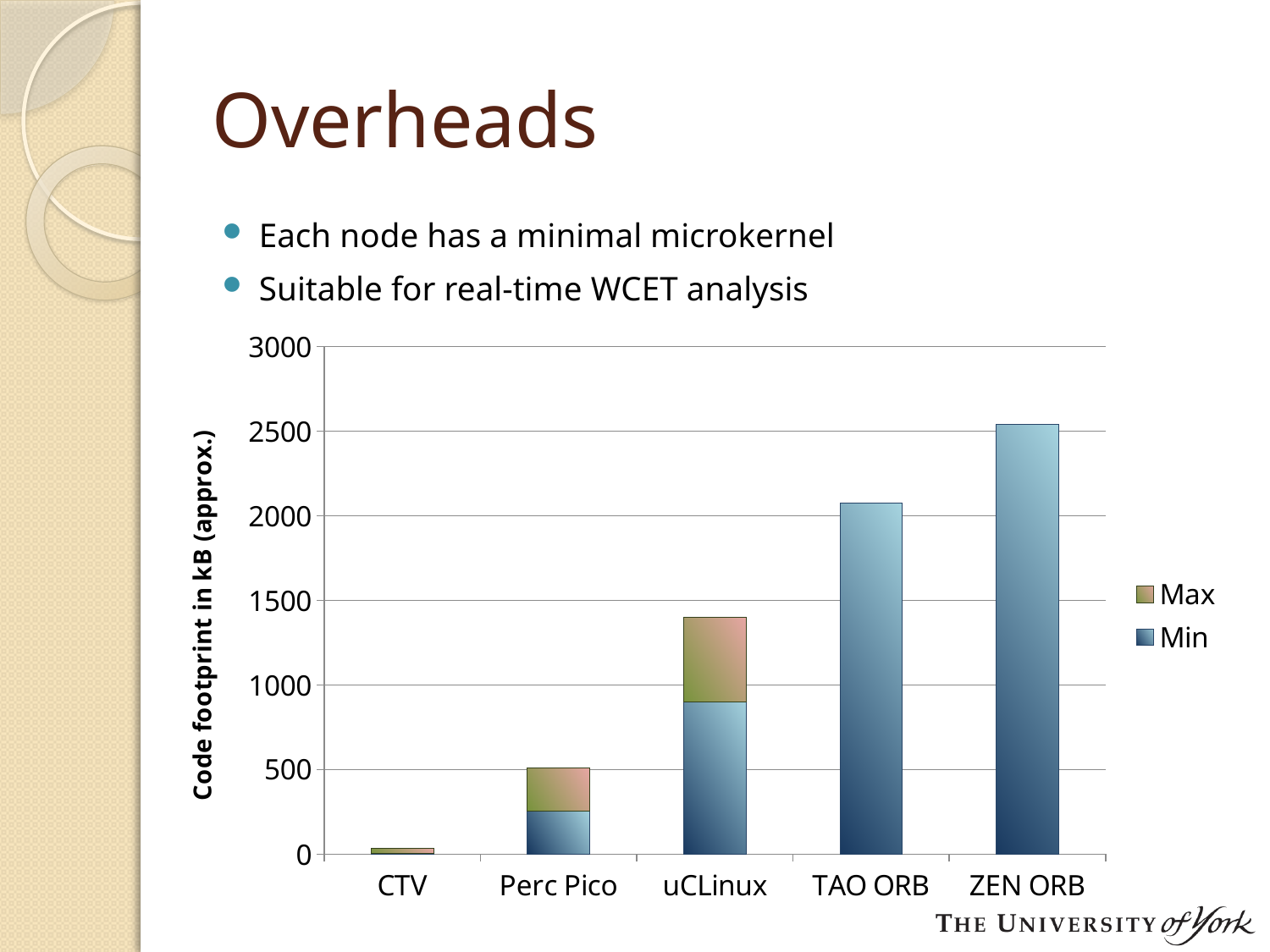
Is the value for CTV greater or less than 500? less What kind of chart is shown on the slide? bar chart Do the bar heights rise or fall moving from CTV to ZEN ORB along the x axis? rise Which category has the shortest bar in the chart? CTV How many series does the chart's legend list? 2 Is the value for ZEN ORB greater or less than 2000? greater What is the title of the chart's vertical axis? Code footprint in kB (approx.) Which bar is taller, TAO ORB or uCLinux? TAO ORB Is the value for TAO ORB greater or less than 2000? greater Which category has the tallest bar in the chart? ZEN ORB How many categories are shown on the x axis of the chart? 5